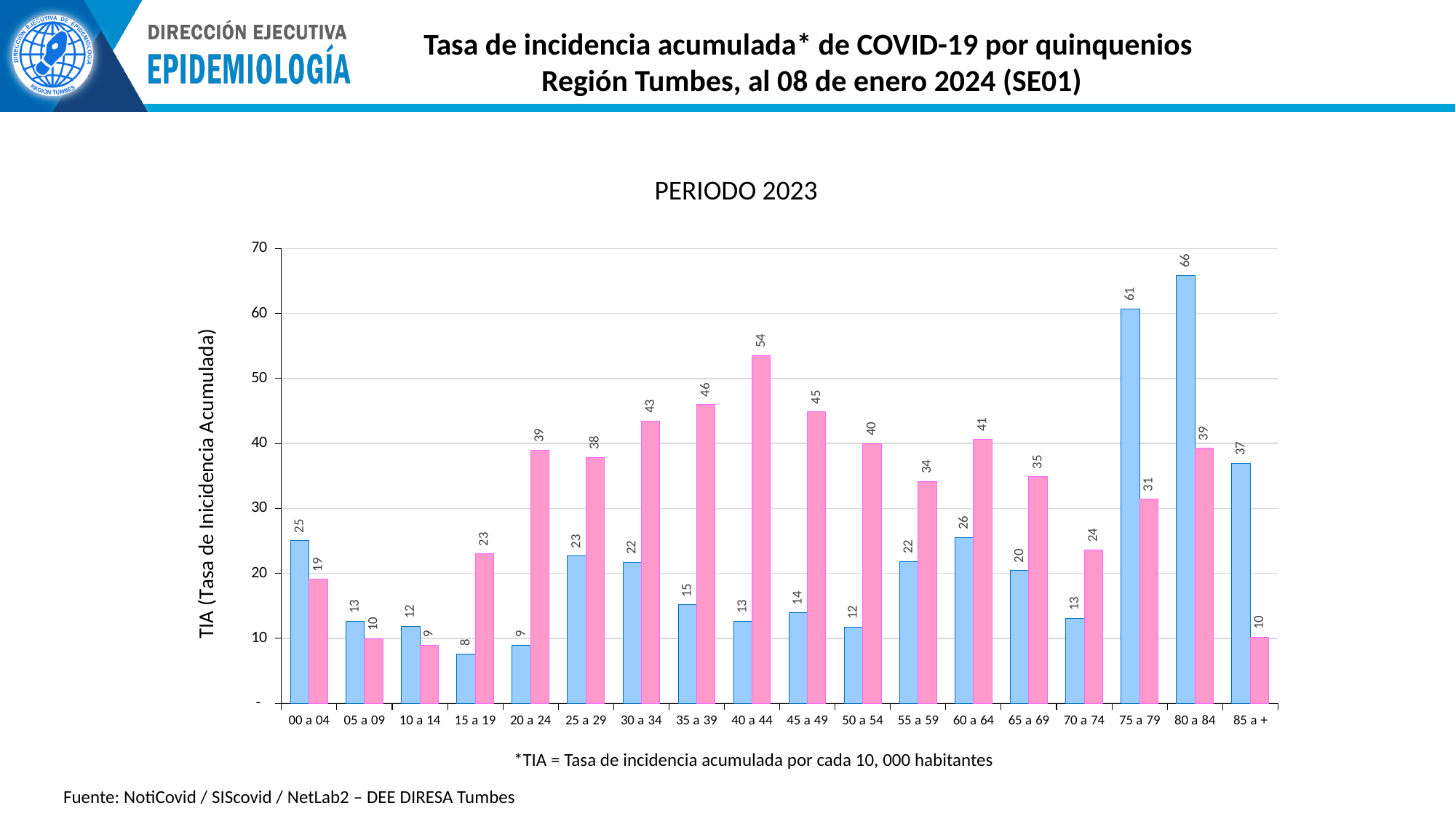
What kind of chart is shown on the slide? bar chart How many bars are plotted for each age group? 2 What is the value of the blue bar for the 85 a + age group? 37 What is the difference between the blue and pink bars for the 75 a 79 age group? 30 How many age-group categories are shown on the x axis? 18 For the 25 a 29 age group, which bar is larger, the blue or the pink? pink Which age group has the highest blue bar? 80 a 84 What is the value of the pink bar for the 40 a 44 age group? 54 Which age group has the highest pink bar? 40 a 44 What is the title shown above the chart? PERIODO 2023 Which age group has the lowest blue bar? 15 a 19 What is the value of the blue bar for the 80 a 84 age group? 66